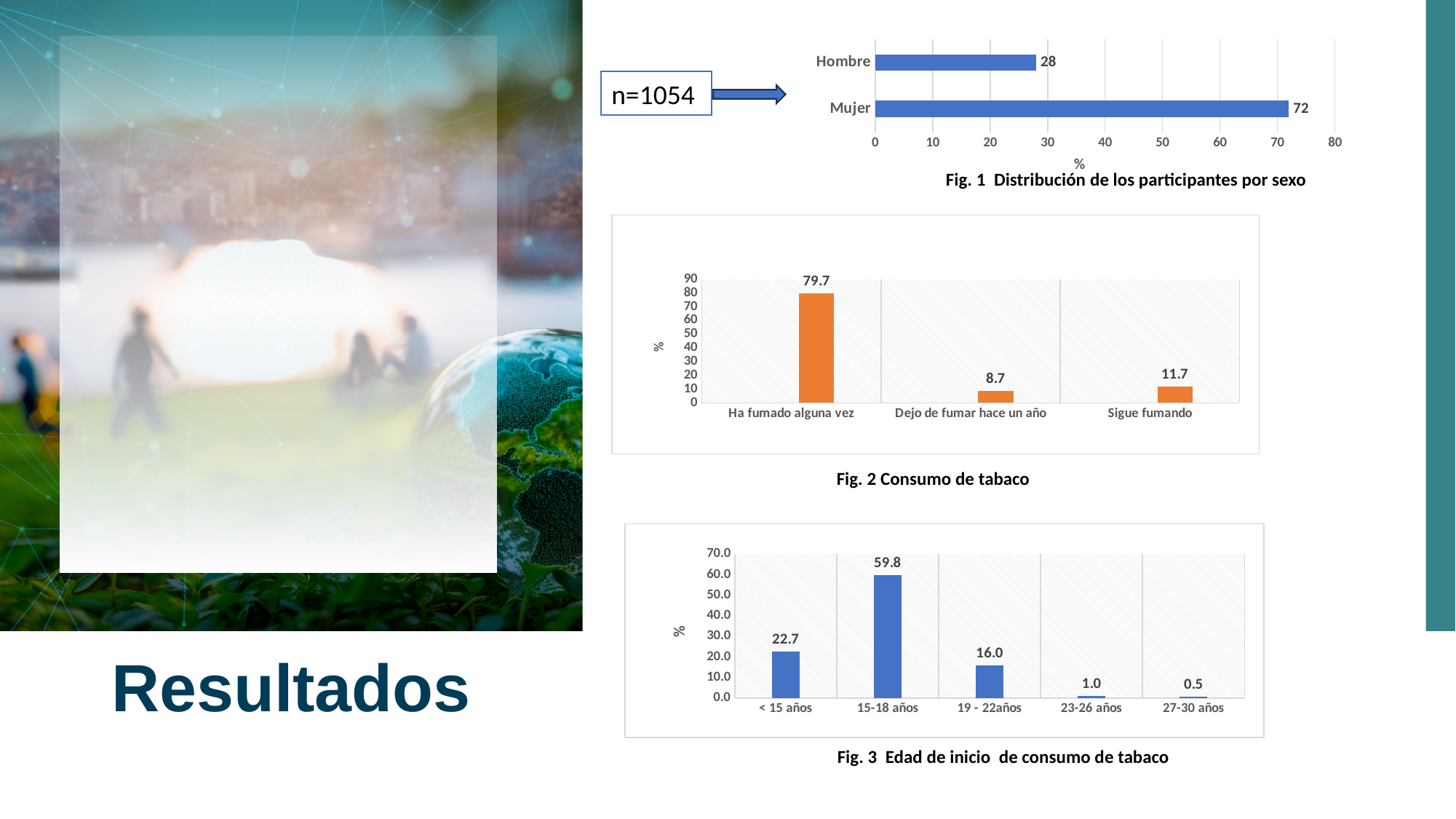
In Fig. 1 (Distribución de los participantes por sexo), what is the difference between the values for Mujer and Hombre? 44 In Fig. 3 (Edad de inicio de consumo de tabaco), what is the difference between the values for < 15 años and 19 - 22años? 6.7 In Fig. 3 (Edad de inicio de consumo de tabaco), what is the value for 15-18 años? 59.8 In Fig. 2 (Consumo de tabaco), which is larger: 'Sigue fumando' or 'Dejo de fumar hace un año'? Sigue fumando In Fig. 1 (Distribución de los participantes por sexo), what kind of chart is shown? Bar chart In Fig. 2 (Consumo de tabaco), how many categories are shown? 3 In Fig. 1 (Distribución de los participantes por sexo), what is the value for Mujer? 72 In Fig. 3 (Edad de inicio de consumo de tabaco), how many age categories are shown? 5 In Fig. 2 (Consumo de tabaco), what is the value for 'Ha fumado alguna vez'? 79.7 In Fig. 3 (Edad de inicio de consumo de tabaco), what is the value for 27-30 años? 0.5 In Fig. 3 (Edad de inicio de consumo de tabaco), which category has the highest value? 15-18 años In Fig. 2 (Consumo de tabaco), which category has the lowest value? Dejo de fumar hace un año